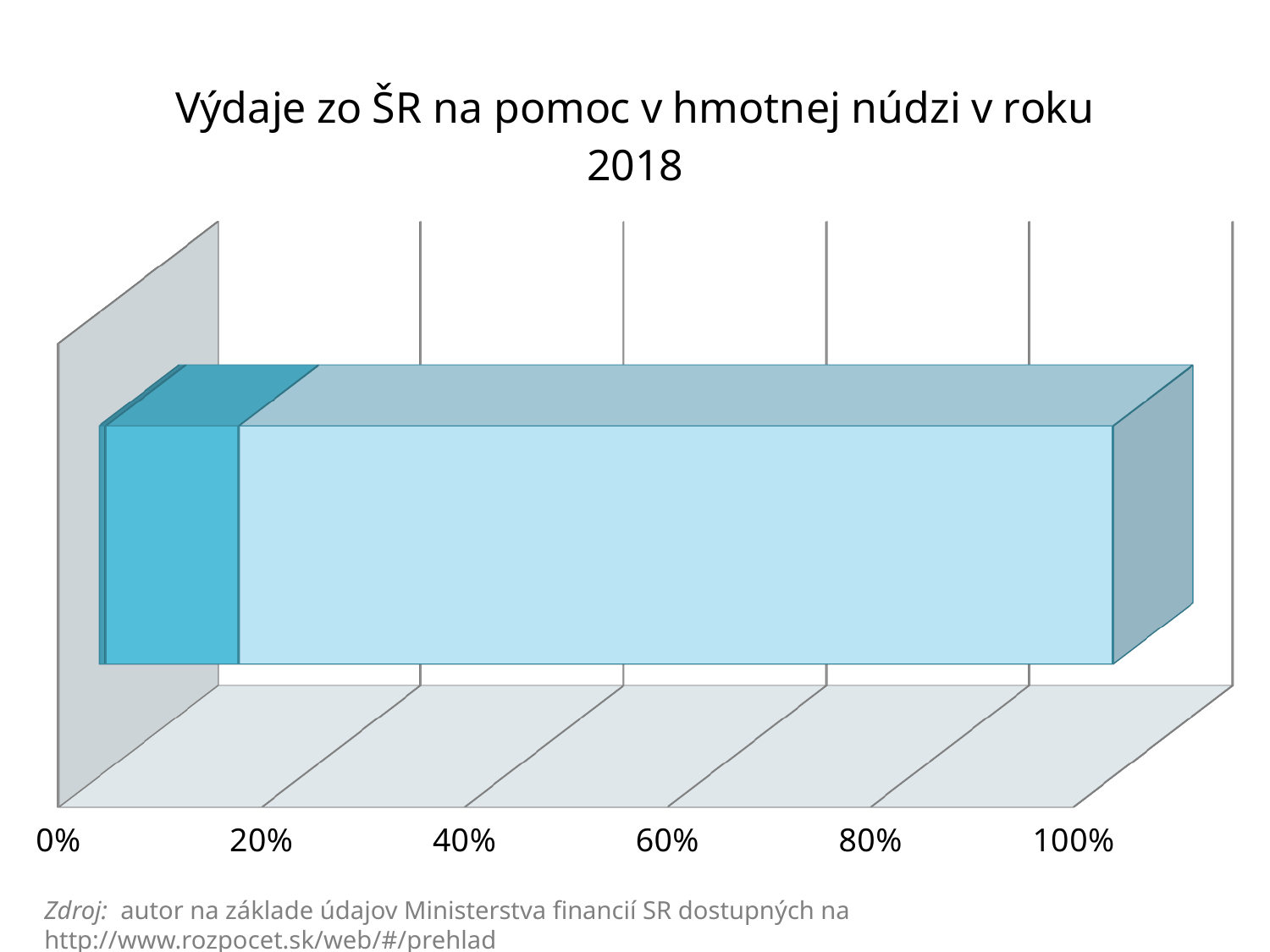
Is the value of the lighter (right) segment of the bar greater or less than 60%? greater Is the value of the darker (left) segment of the bar greater or less than 20%? less What is the title of the chart? Výdaje zo ŠR na pomoc v hmotnej núdzi v roku 2018 Which segment of the bar is larger, the darker left segment or the lighter right segment? the lighter right segment How many tick labels are shown on the horizontal axis? 6 What is the highest value labelled on the horizontal axis? 100% Does the whole bar reach the 100% mark on the axis? yes How many coloured segments make up the bar? 3 How many bars are plotted in the chart? 1 What kind of chart is shown on the slide? bar chart